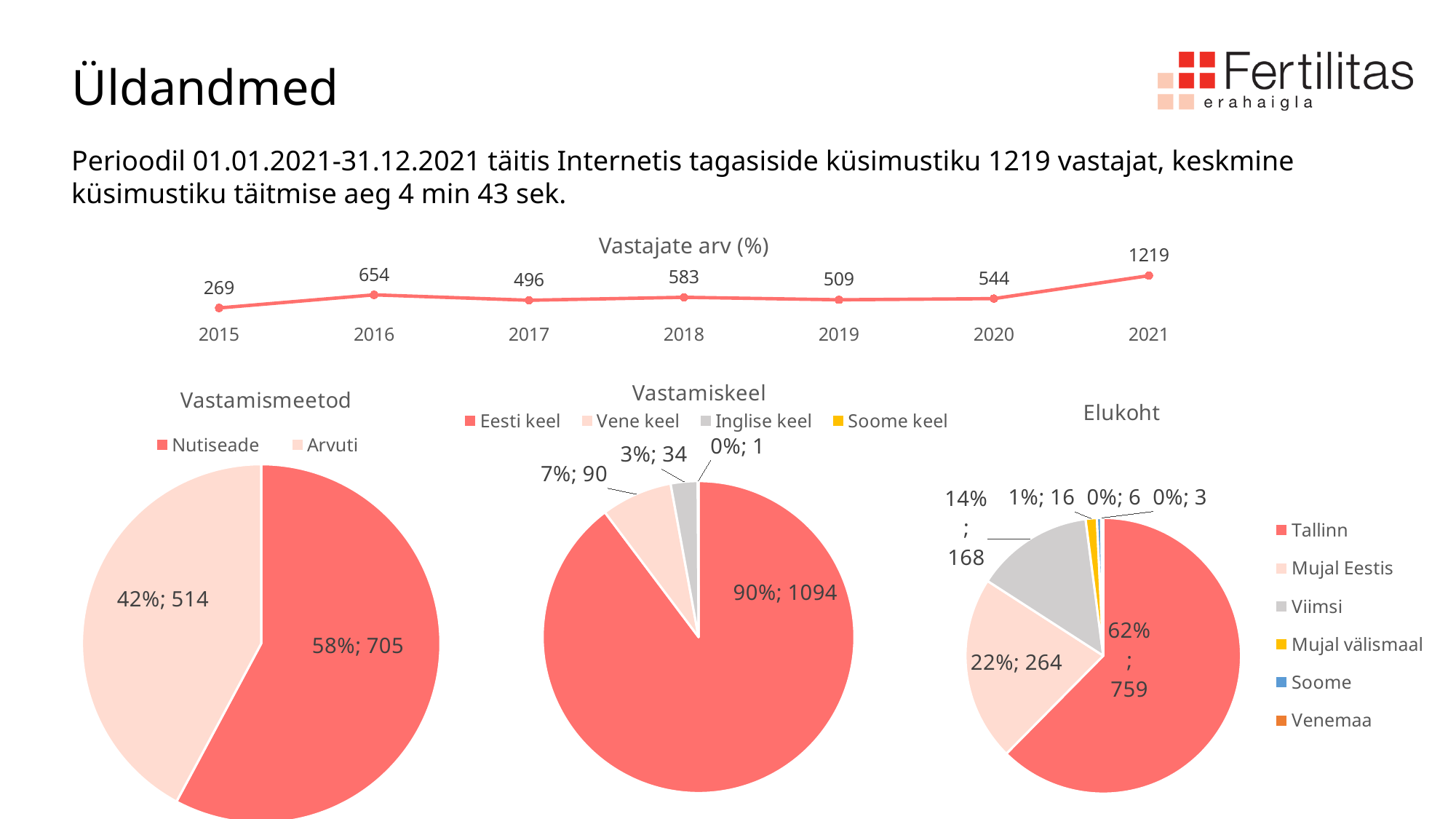
In the 'Elukoht' pie chart, what is the count for Mujal Eestis? 264 How many entries does the legend of the 'Vastamiskeel' pie chart list? 4 In the line chart 'Vastajate arv (%)', which year has the lowest value? 2015 In the line chart 'Vastajate arv (%)', how many years are plotted? 7 In the 'Vastamiskeel' pie chart, what is the count for Vene keel? 90 In the 'Vastamismeetod' pie chart, what is the difference between the counts for Nutiseade and Arvuti? 191 In the 'Elukoht' pie chart, which is larger, Viimsi or Mujal Eestis? Mujal Eestis In the 'Vastamismeetod' pie chart, what share does Arvuti have? 42% In the line chart 'Vastajate arv (%)', what is the difference between the values for 2021 and 2020? 675 In the 'Vastamismeetod' pie chart, what is the count for Nutiseade? 705 In the line chart 'Vastajate arv (%)', what is the value for 2021? 1219 What kind of chart is 'Vastajate arv (%)'? line chart